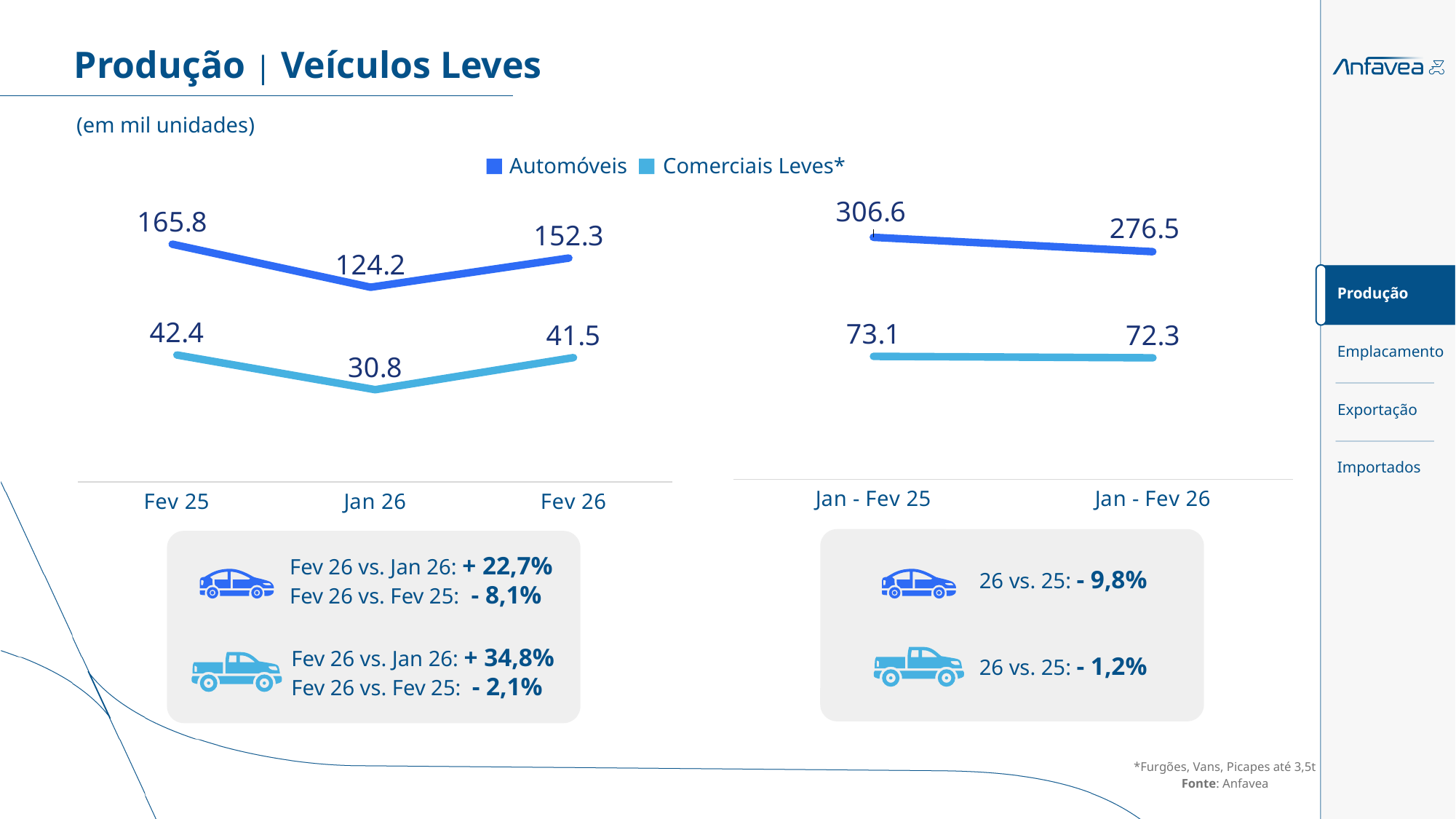
In the right chart (Jan - Fev), what is the difference between the Automóveis values for Jan - Fev 25 and Jan - Fev 26? 30.1 In the left chart (monthly), what is the value for Comerciais Leves* in Fev 26? 41.5 In the left chart (monthly), what is the value for Automóveis in Jan 26? 124.2 In the left chart (monthly), what is the difference between the Automóveis values for Fev 25 and Fev 26? 13.5 In the left chart (monthly), which is larger: Comerciais Leves* in Fev 25 or in Fev 26? Fev 25 In the right chart (Jan - Fev), does the Automóveis line rise or fall from Jan - Fev 25 to Jan - Fev 26? fall What kind of chart is used on the slide? line chart In the left chart (monthly), which month has the lowest value for Automóveis? Jan 26 In the right chart (Jan - Fev), what is the value for Automóveis in Jan - Fev 26? 276.5 In the right chart (Jan - Fev), what is the value for Comerciais Leves* in Jan - Fev 25? 73.1 In the left chart (monthly), which month has the highest value for Comerciais Leves*? Fev 25 How many series does the legend list? 2